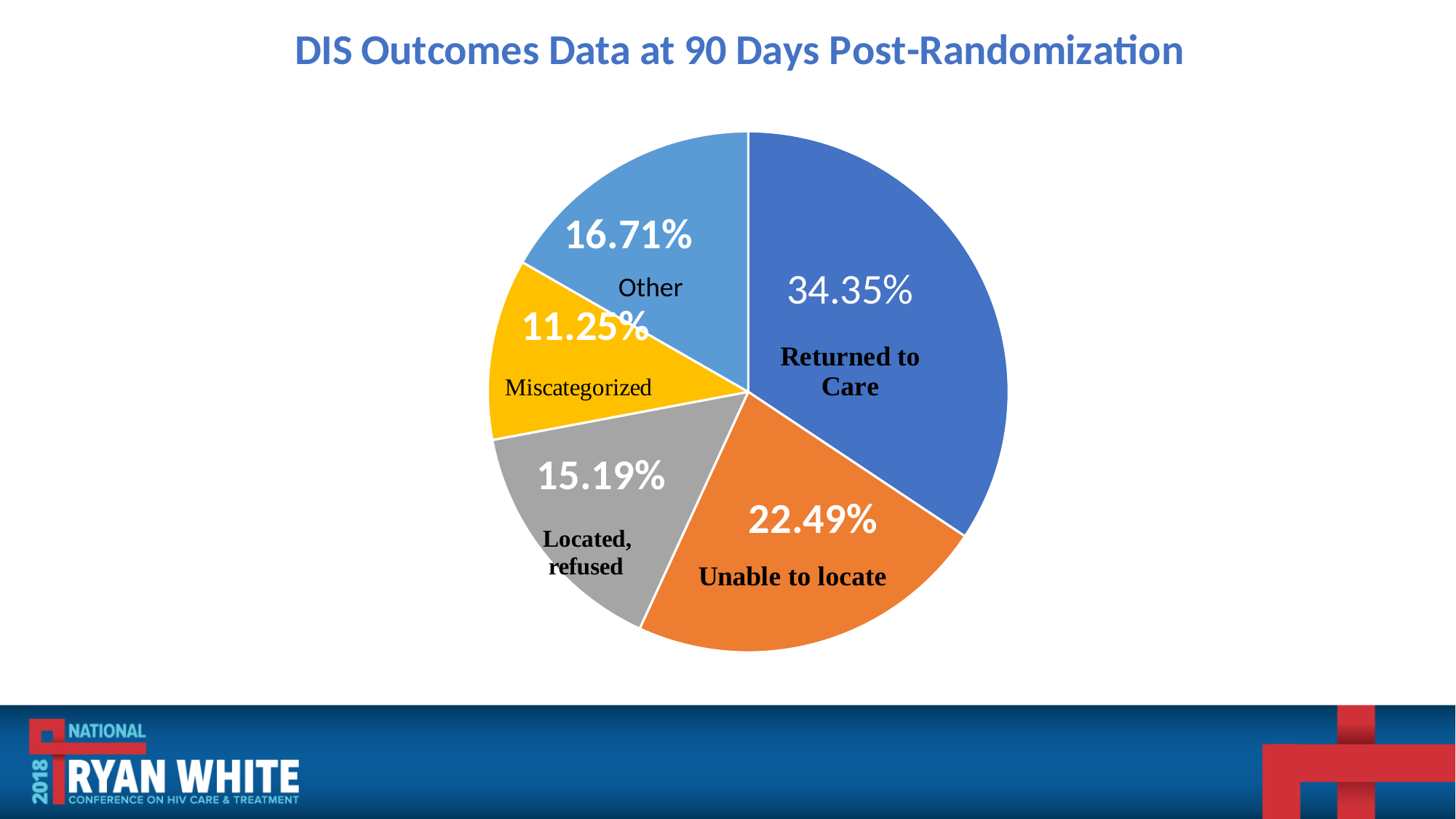
What is the title of the chart? DIS Outcomes Data at 90 Days Post-Randomization What percentage of the pie is labelled Miscategorized? 11.25% What is the difference in percentage points between Returned to Care and Unable to locate? 11.86 What percentage of the pie is labelled Other? 16.71% What percentage of the pie is labelled Returned to Care? 34.35% How many slices does the pie chart have? 5 What percentage of the pie is labelled Unable to locate? 22.49% Which category has the smallest share of the pie? Miscategorized What kind of chart is shown on the slide? Pie chart Which category has the largest share of the pie? Returned to Care What percentage of the pie is labelled Located, refused? 15.19% Which is larger, the share for Other or the share for Located, refused? Other